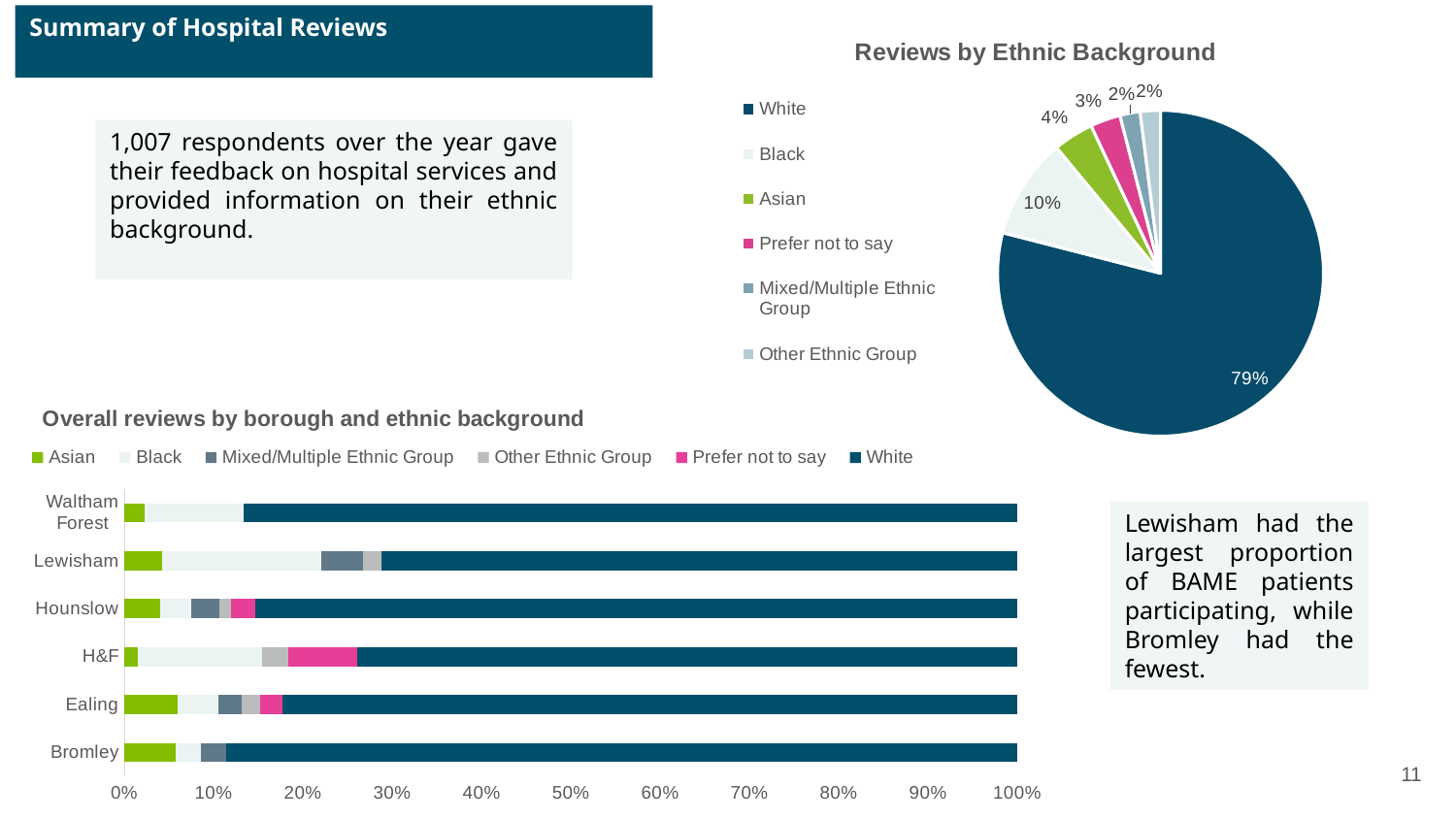
How many slices does the 'Reviews by Ethnic Background' pie chart have? 6 How many boroughs are shown in the 'Overall reviews by borough and ethnic background' chart? 6 What type of chart is 'Reviews by Ethnic Background'? Pie chart In the 'Reviews by Ethnic Background' pie chart, what is the difference in percentage points between the White and Black slices? 69 In the 'Reviews by Ethnic Background' pie chart, which is larger, the Asian slice or the Prefer not to say slice? Asian In the 'Reviews by Ethnic Background' pie chart, what share of reviews came from Black respondents? 10% In the 'Reviews by Ethnic Background' pie chart, what percentage of reviews came from White respondents? 79% How many series does the legend of the 'Overall reviews by borough and ethnic background' chart list? 6 In the 'Reviews by Ethnic Background' pie chart, which ethnic group has the largest slice? White What type of chart is 'Overall reviews by borough and ethnic background'? Bar chart In the 'Reviews by Ethnic Background' pie chart, what percentage is shown for Asian respondents? 4% In the 'Overall reviews by borough and ethnic background' chart, which borough has the largest Prefer not to say segment? H&F